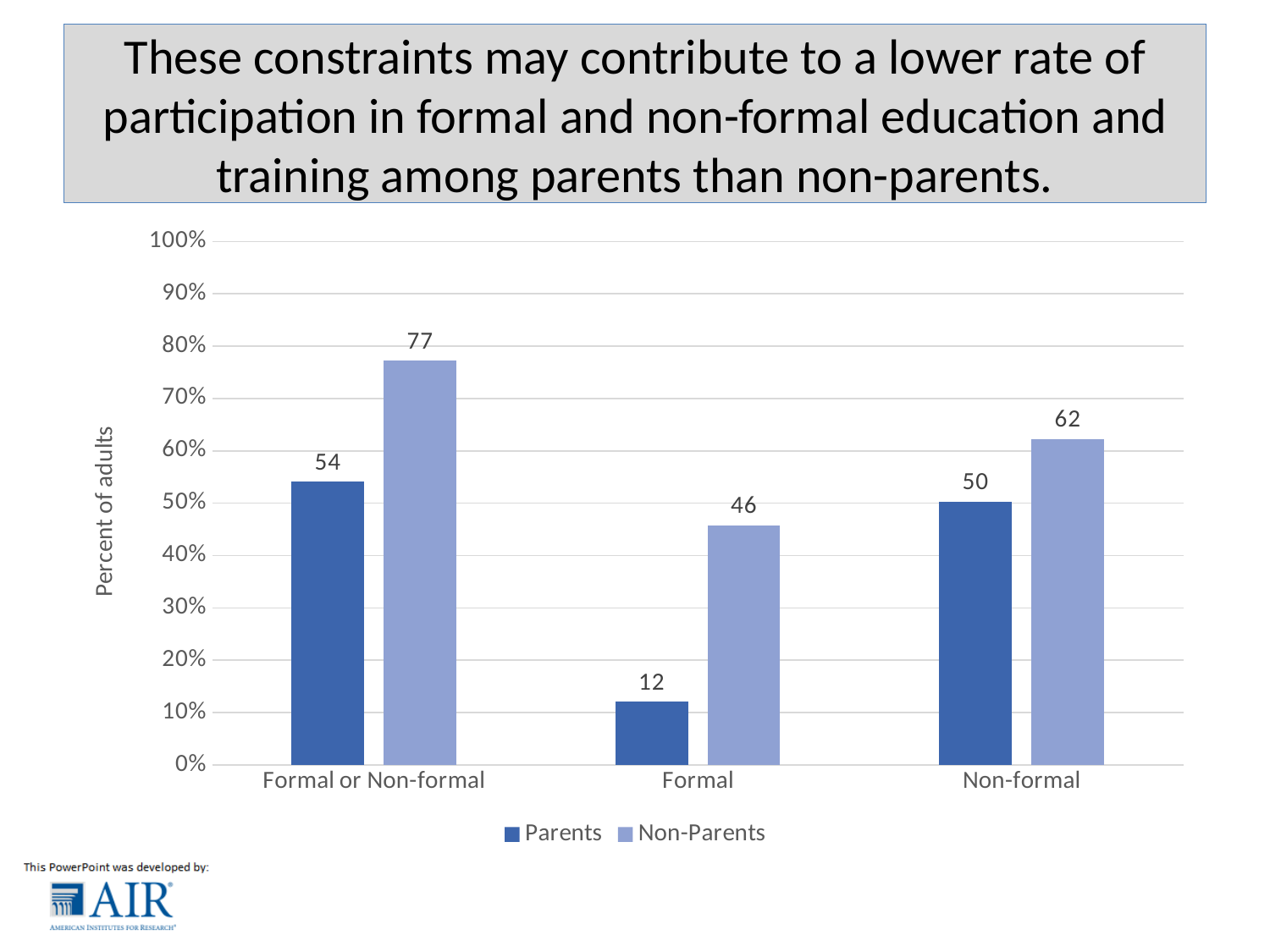
How many series does the legend list? 2 What is the value for Non-Parents in the Formal category? 46 What is the difference between Non-Parents and Parents in the Non-formal category? 12 How many categories are shown on the x axis? 3 Is the value for Non-Parents in the Formal or Non-formal category greater or less than 70%? greater What is the value for Parents in the Formal or Non-formal category? 54 Which category has the highest value for Non-Parents? Formal or Non-formal What kind of chart is shown on the slide? bar chart What is the difference between Non-Parents and Parents in the Formal category? 34 Which category has the lowest value for Parents? Formal Which is larger in the Formal or Non-formal category, Parents or Non-Parents? Non-Parents What is the value for Parents in the Non-formal category? 50